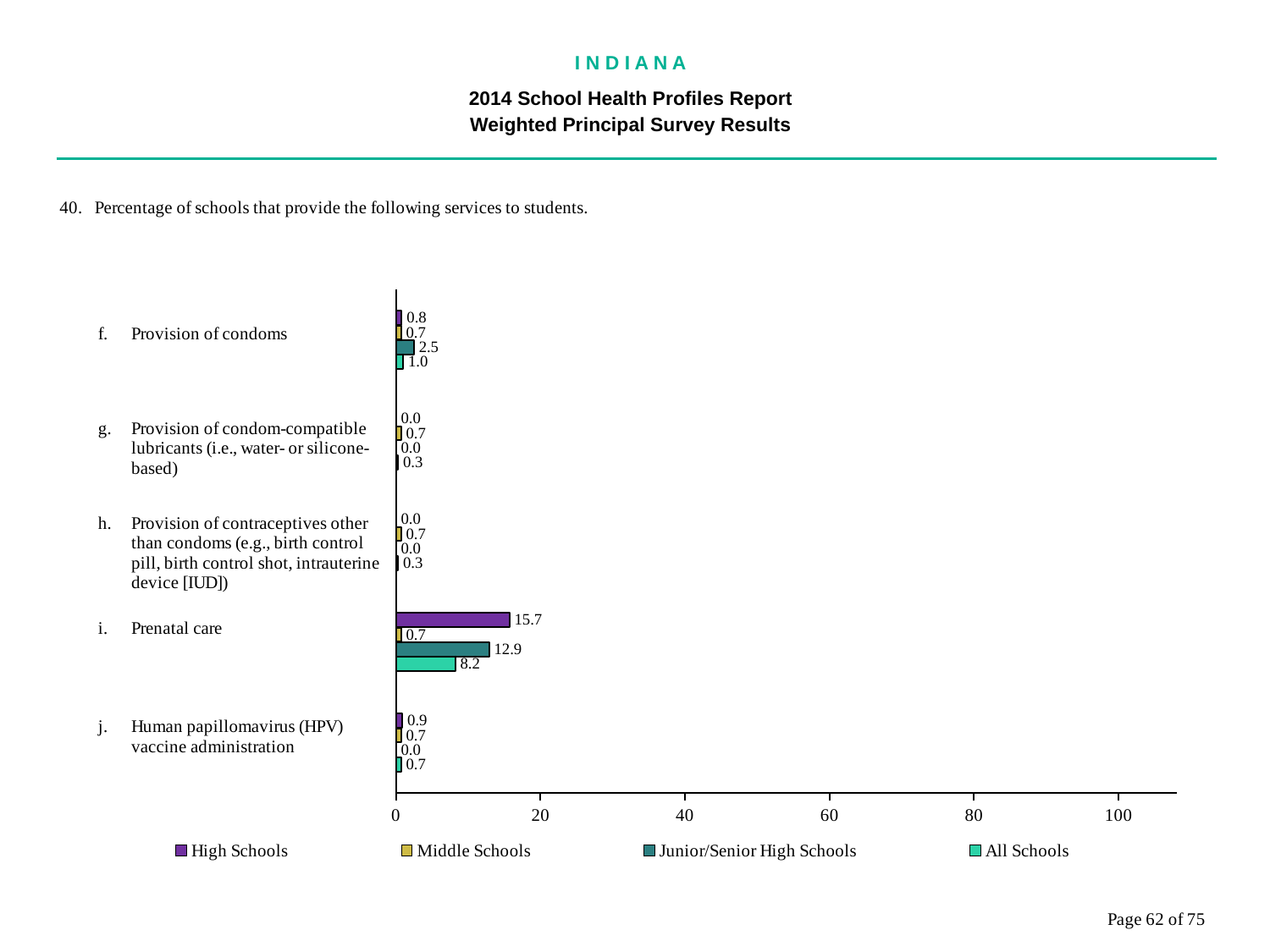
What is the value for Middle Schools for Human papillomavirus (HPV) vaccine administration? 0.7 How many services (categories) are shown on the chart? 5 What kind of chart is shown on the slide? bar chart Is the High Schools value for Prenatal care greater or less than 20? less How many series does the legend list? 4 For Provision of condoms, which is larger: the Junior/Senior High Schools value or the All Schools value? Junior/Senior High Schools Which service has the highest value for High Schools? Prenatal care What is the value for High Schools for Prenatal care? 15.7 Which series is shown in purple in the legend? High Schools What is the difference between the High Schools and Junior/Senior High Schools values for Prenatal care? 2.8 What is the value for All Schools for Prenatal care? 8.2 What is the value for Junior/Senior High Schools for Provision of condoms? 2.5